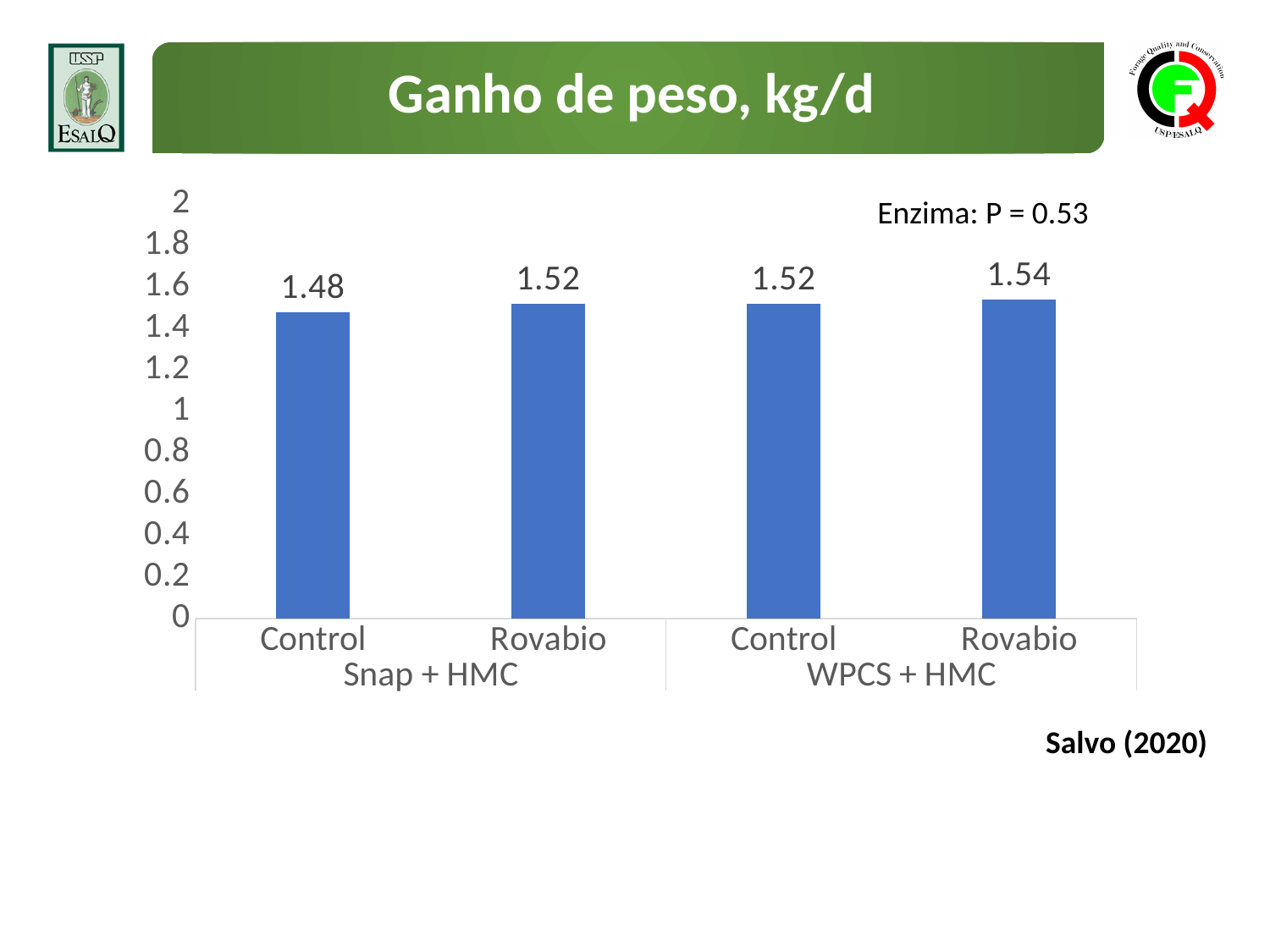
What is the title of the chart? Ganho de peso, kg/d Which is larger, Control under Snap + HMC or Control under WPCS + HMC? Control under WPCS + HMC Is the value for Control under Snap + HMC greater or less than 1.6? less Which bar has the highest value? Rovabio (WPCS + HMC) What is the value for Control under Snap + HMC? 1.48 How many bars are plotted in the chart? 4 What kind of chart is shown on the slide? bar chart Which bar has the lowest value? Control (Snap + HMC) What is the value for Rovabio under WPCS + HMC? 1.54 What is the value for Rovabio under Snap + HMC? 1.52 What is the difference between Rovabio and Control under WPCS + HMC? 0.02 What is the difference between Rovabio and Control under Snap + HMC? 0.04